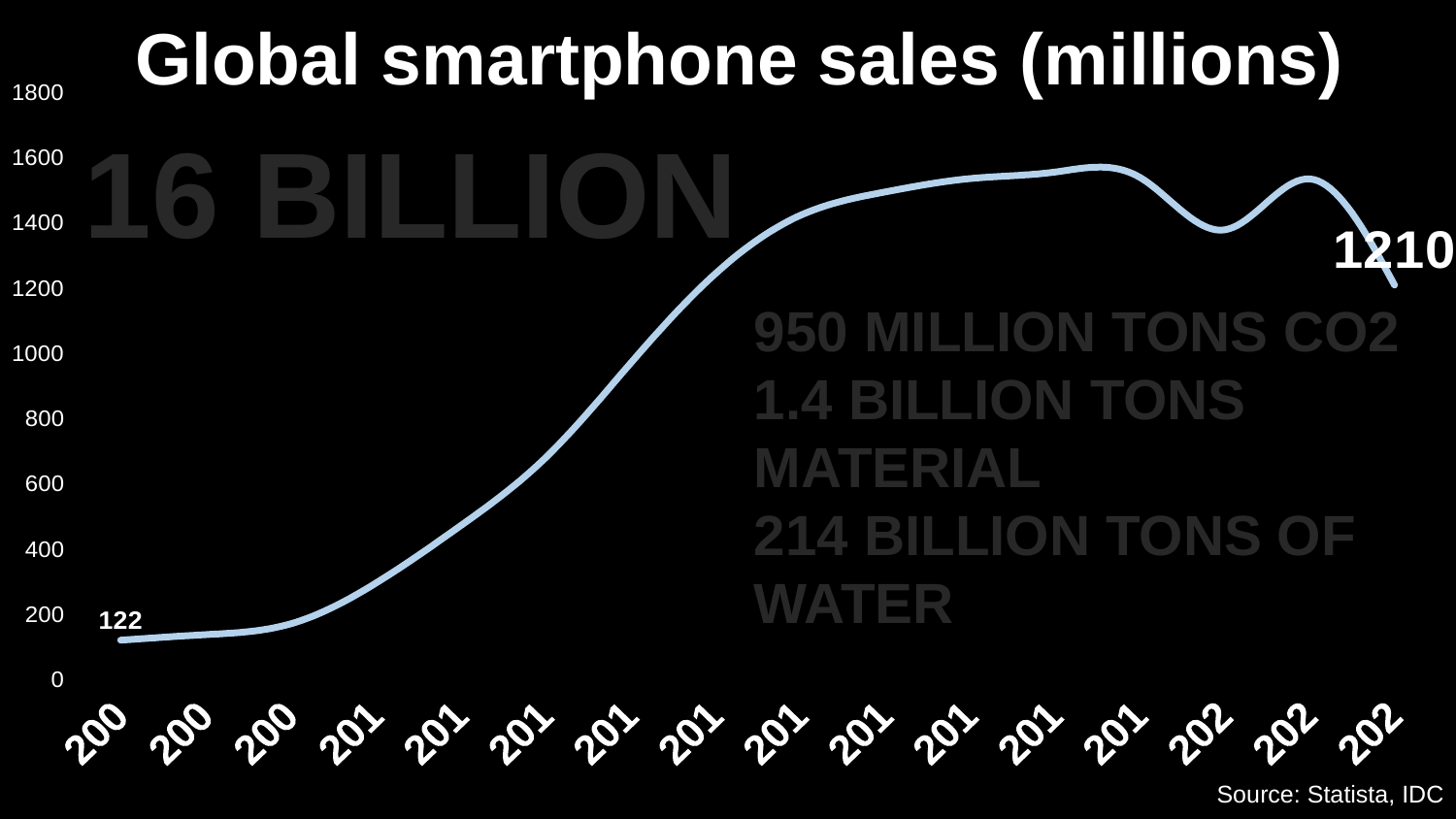
What is the value shown at the last data point of the line? 1210 What is the title of the chart? Global smartphone sales (millions) What is the value shown at the first data point of the line? 122 What is the difference between the last data point (1210) and the first data point (122)? 1088 How many data points are plotted along the x axis? 16 Does the line generally rise or fall from the left of the x axis to the right? rise What kind of chart is shown on the slide? line chart What is the maximum value shown on the y axis? 1800 Which is larger, the value at the first data point or the value at the last data point? the last data point (1210) Is the value at the first data point greater or less than 200? less Is the highest point of the line greater or less than 1400? greater